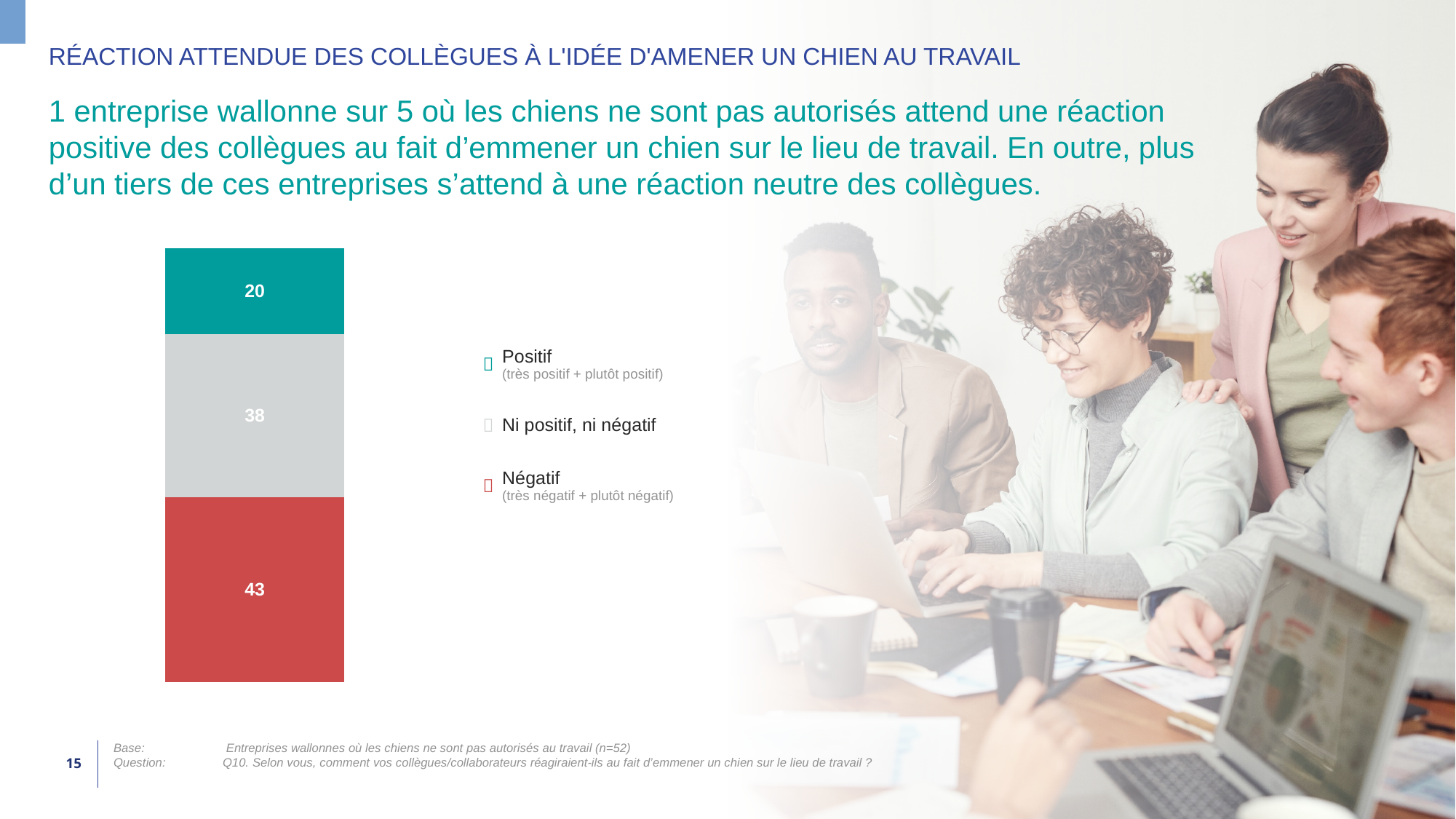
Which is larger, the Positif value or the Ni positif, ni négatif value? Ni positif, ni négatif What is the difference between the Négatif and Ni positif, ni négatif values? 5 What value is shown for the Positif segment of the stacked bar? 20 Which segment of the stacked bar has the lowest value? Positif How many segments does the stacked bar contain? 3 What colour is the Négatif segment of the bar? Red What is the total of the three segments in the stacked bar? 101 What value is shown for the Négatif segment? 43 What is the difference between the Négatif and Positif values? 23 How many entries does the legend list? 3 What value is shown for the Ni positif, ni négatif segment? 38 Which segment of the stacked bar has the highest value? Négatif